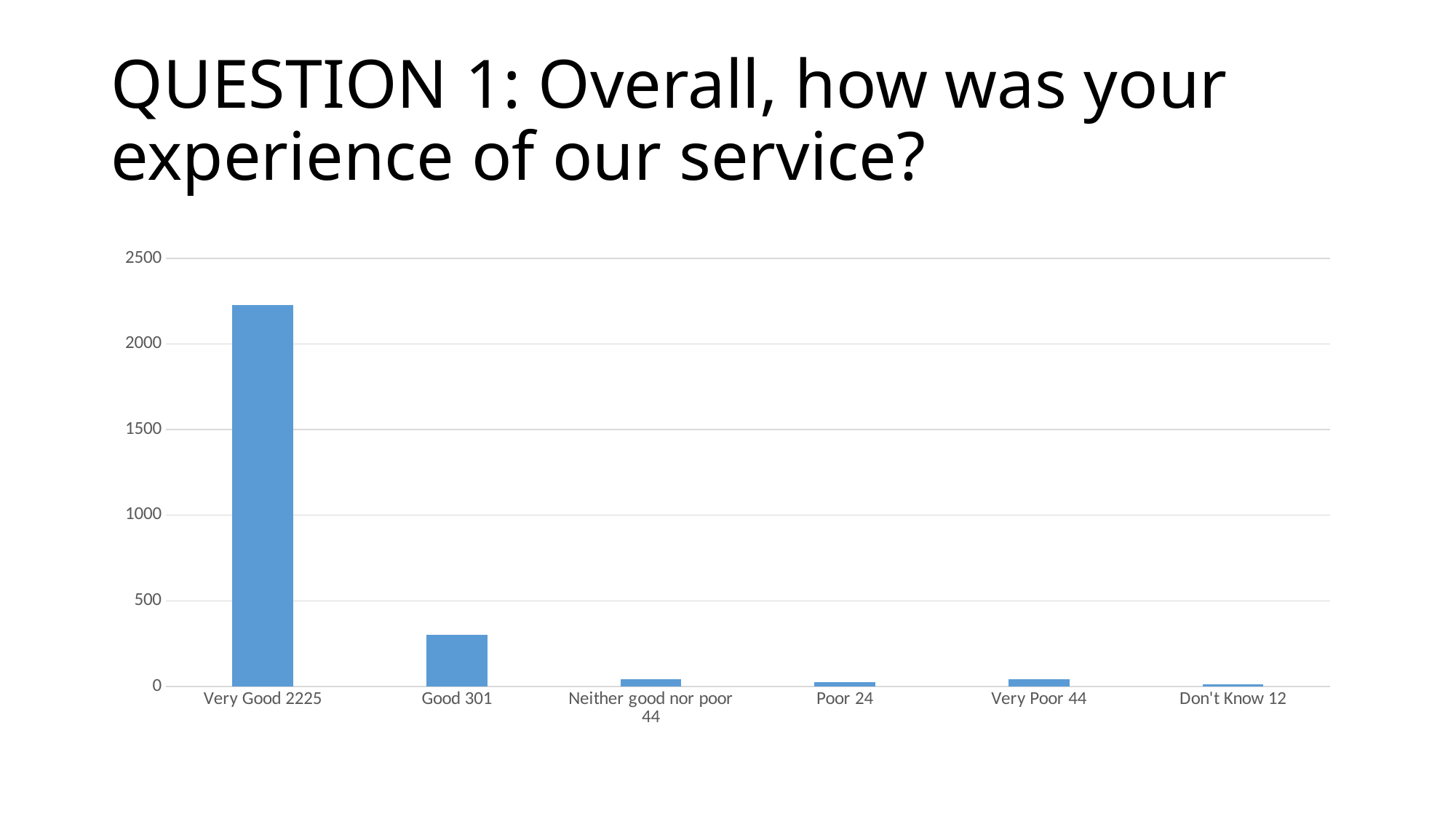
What is the value for Good? 301 Which category has the lowest value? Don't Know Which is larger, the value for Good or the value for Very Poor? Good What is the value for Very Good? 2225 Is the value for Very Good greater or less than 2000? greater What kind of chart is shown on the slide? bar chart What is the difference between the values for Very Good and Good? 1924 What is the value for Don't Know? 12 What is the title of the slide containing the chart? QUESTION 1: Overall, how was your experience of our service? Which category has the highest value? Very Good How many categories are shown on the x axis of the chart? 6 What is the value for Poor? 24